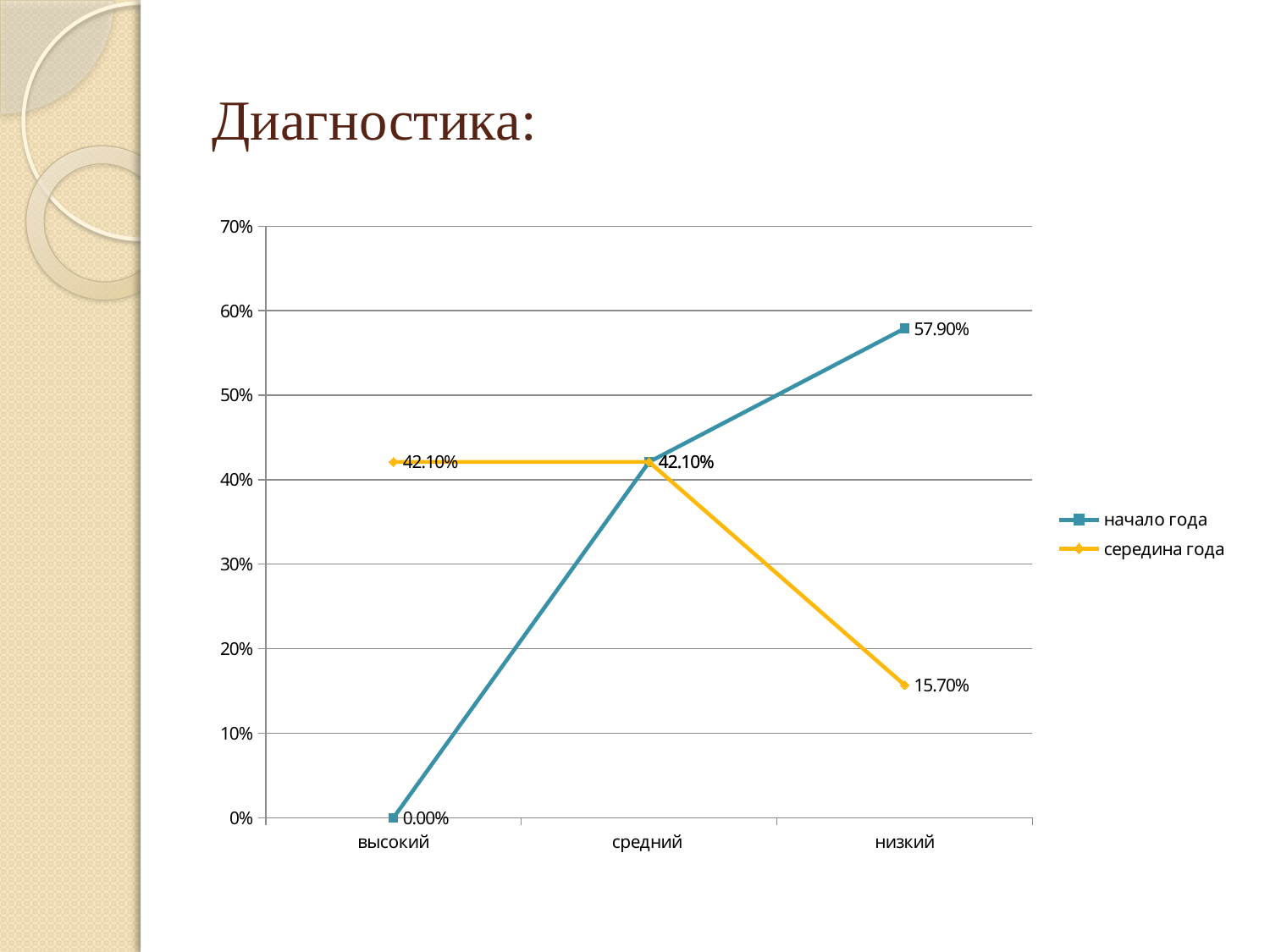
How many categories are shown on the x axis? 3 For the series начало года, which category has the highest value? низкий How many series does the legend list? 2 What kind of chart is shown on the slide? line chart What is the value for середина года at высокий? 42.10% Does the середина года line rise or fall from средний to низкий? fall For the series середина года, which category has the lowest value? низкий What is the value for начало года at высокий? 0.00% What is the value for середина года at низкий? 15.70% At низкий, which series has the larger value, начало года or середина года? начало года What is the difference between the начало года values at низкий and высокий? 57.90% What is the value for начало года at низкий? 57.90%